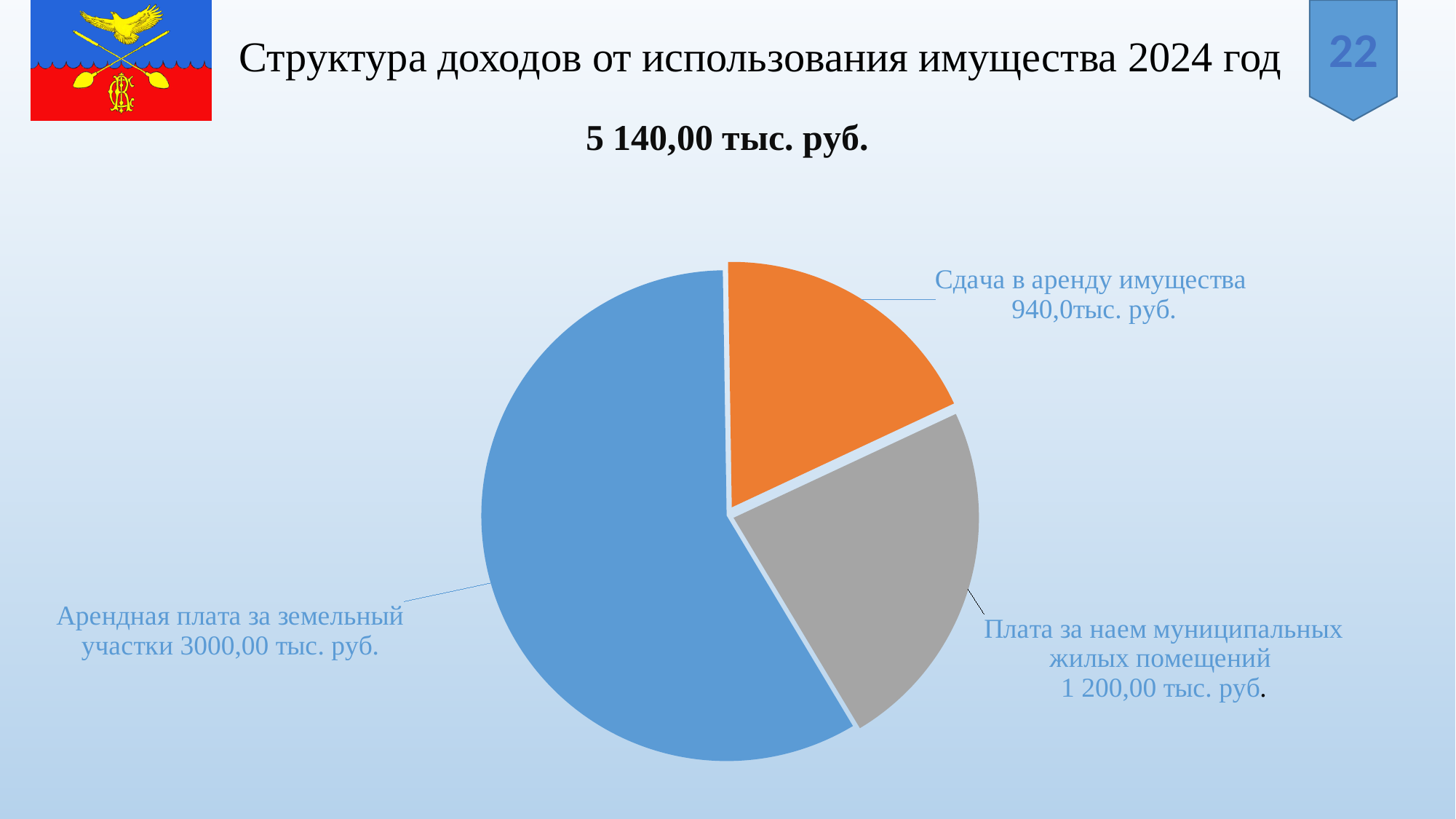
What is the value for "Плата за наем муниципальных жилых помещений"? 1 200,00 тыс. руб. What colour is the slice for "Сдача в аренду имущества"? Orange What total amount is shown above the pie chart? 5 140,00 тыс. руб. What is the difference between "Арендная плата за земельный участки" and "Плата за наем муниципальных жилых помещений"? 1 800,00 тыс. руб. What is the difference between "Плата за наем муниципальных жилых помещений" and "Сдача в аренду имущества"? 260,00 тыс. руб. Which category has the largest slice of the pie? Арендная плата за земельный участки What kind of chart is shown on the slide? Pie chart How many slices does the pie chart have? 3 Which category has the smallest slice of the pie? Сдача в аренду имущества Which is larger: "Плата за наем муниципальных жилых помещений" or "Сдача в аренду имущества"? Плата за наем муниципальных жилых помещений What is the value for "Арендная плата за земельный участки"? 3000,00 тыс. руб. What is the value for "Сдача в аренду имущества"? 940,0 тыс. руб.